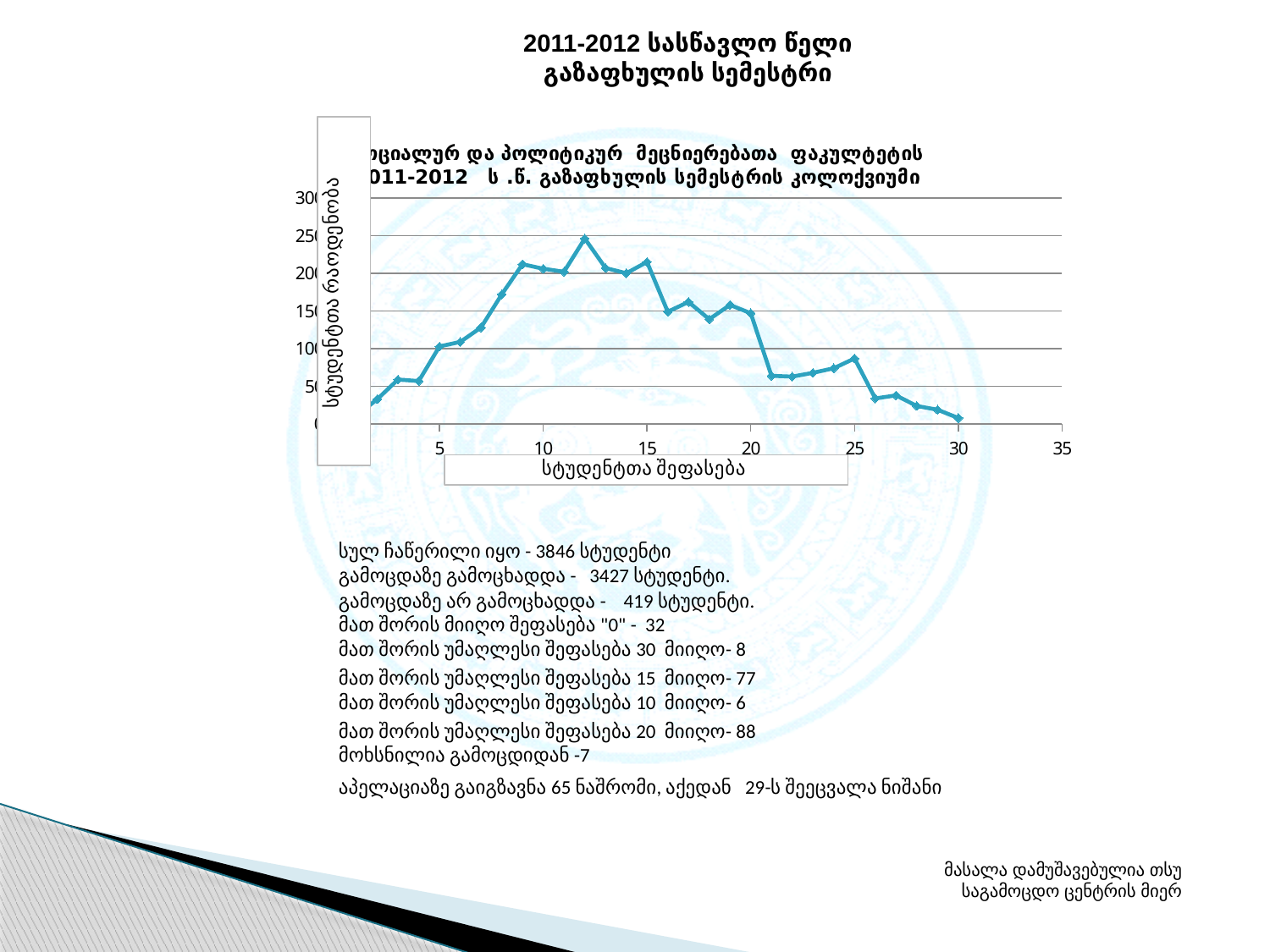
Does the line generally rise or fall between grade 25 and grade 30? fall At which student grade (x-axis value) does the line reach its highest point? 12 Is the number of students at grade 25 greater or less than 100? less Is the number of students at grade 12 greater or less than 200? greater Which has more students: grade 25 or grade 30? grade 25 Which has more students: grade 12 or grade 15? grade 12 What kind of chart is shown on the slide? line chart What is the title of the x axis of the chart? სტუდენტთა შეფასება Does the line generally rise or fall between grade 2 and grade 12? rise At which student grade (x-axis value) does the line reach its lowest point? 30 Is the number of students at grade 2 greater or less than 50? less